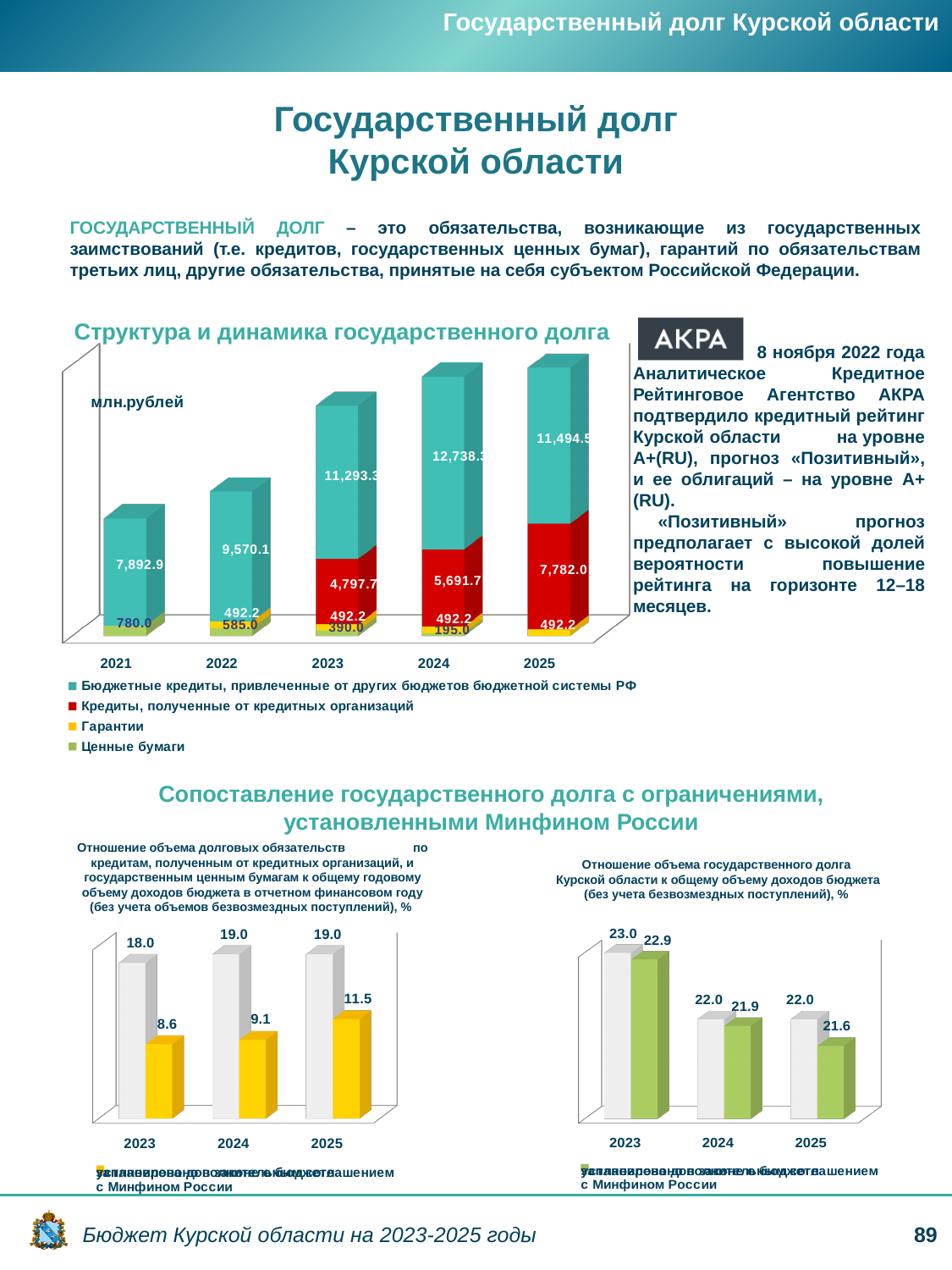
In the bottom-left chart (ratio of debt obligations on credits and securities to budget revenues), do the yellow bar values rise or fall from 2023 to 2025? Rise In the chart 'Структура и динамика государственного долга', how many series does the legend list? 4 In the chart 'Структура и динамика государственного долга', what is the value of the 'Бюджетные кредиты, привлеченные от других бюджетов бюджетной системы РФ' segment for 2021? 7,892.9 In the chart 'Структура и динамика государственного долга', which year has the largest 'Кредиты, полученные от кредитных организаций' segment? 2025 What type of chart is 'Структура и динамика государственного долга'? Stacked bar chart In the bottom-right chart (ratio of state debt to total budget revenues), which year has the highest grey bar value? 2023 In the chart 'Структура и динамика государственного долга', what is the value of the 'Кредиты, полученные от кредитных организаций' segment for 2025? 7,782.0 In the chart 'Структура и динамика государственного долга', what is the difference between the 'Кредиты, полученные от кредитных организаций' values for 2024 and 2023? 894.0 In the chart 'Структура и динамика государственного долга', what is the value of the 'Ценные бумаги' segment for 2022? 585.0 In the chart 'Структура и динамика государственного долга', how many years are shown on the x axis? 5 In the bottom-left chart (ratio of debt obligations on credits and securities to budget revenues), what is the value of the yellow bar for 2025? 11.5 In the bottom-right chart (ratio of state debt to total budget revenues), what is the value of the green bar for 2024? 21.9